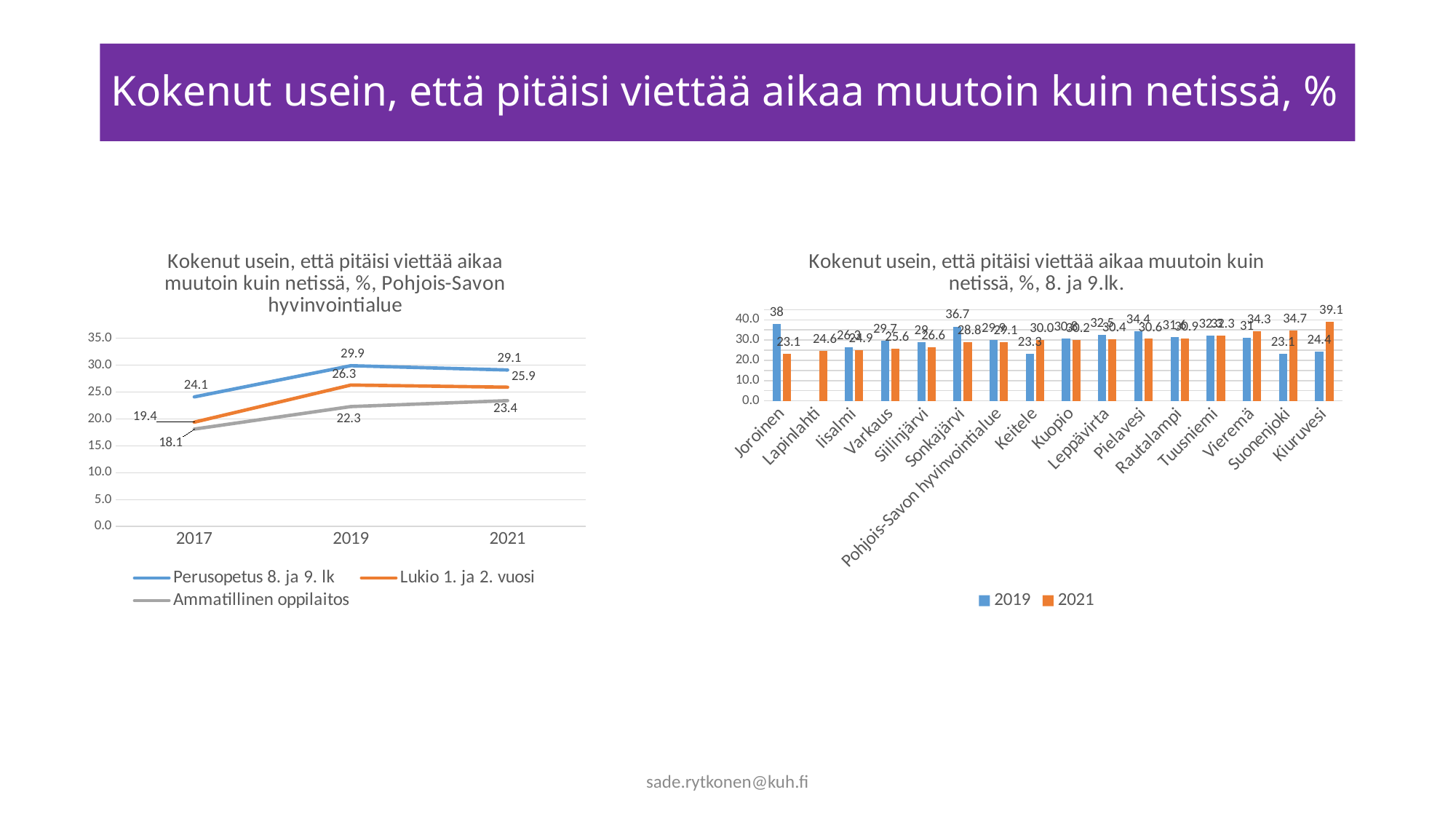
In the left chart (Pohjois-Savon hyvinvointialue), what is the value for Perusopetus 8. ja 9. lk in 2019? 29.9 In the left chart (Pohjois-Savon hyvinvointialue), what is the difference between Perusopetus 8. ja 9. lk and Lukio 1. ja 2. vuosi in 2021? 3.2 In the left chart (Pohjois-Savon hyvinvointialue), how many series does the legend list? 3 What kind of chart is the left chart (Pohjois-Savon hyvinvointialue)? line chart In the right chart (8. ja 9.lk.), which municipality has the highest 2021 value? Kiuruvesi In the left chart (Pohjois-Savon hyvinvointialue), does the Ammatillinen oppilaitos line rise or fall from 2017 to 2021? rise In the right chart (8. ja 9.lk.), which of Joroinen's two bars is larger, 2019 or 2021? 2019 What kind of chart is the right chart (8. ja 9.lk.)? bar chart In the left chart (Pohjois-Savon hyvinvointialue), what is the value for Ammatillinen oppilaitos in 2017? 18.1 In the right chart (8. ja 9.lk.), how many categories are shown on the x axis? 16 In the right chart (8. ja 9.lk.), what is the 2019 value for Joroinen? 38 In the right chart (8. ja 9.lk.), what is the 2021 value for Kiuruvesi? 39.1